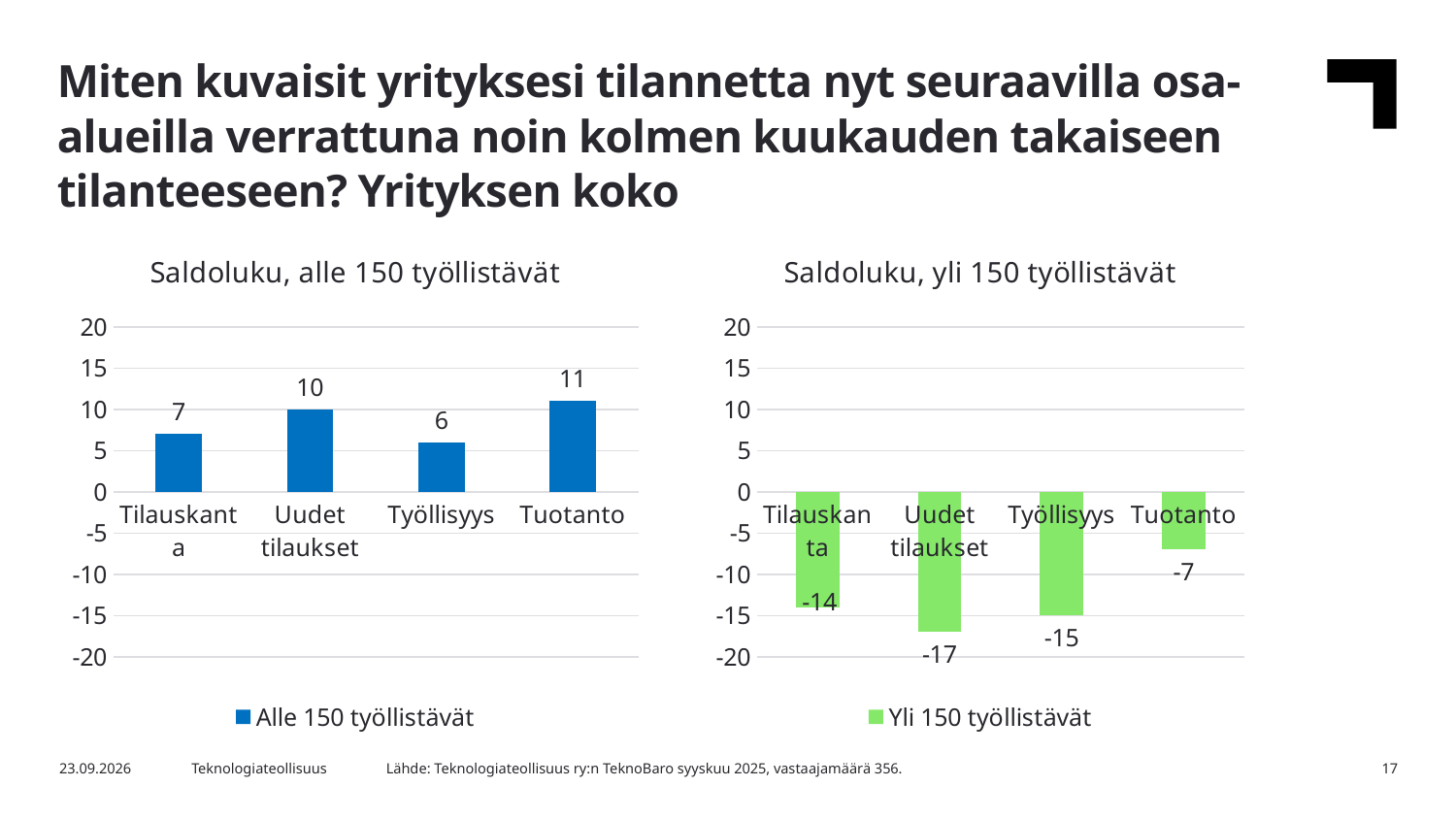
In the chart 'Saldoluku, alle 150 työllistävät', which category has the lowest value? Työllisyys In the chart 'Saldoluku, alle 150 työllistävät', what is the value for Uudet tilaukset? 10 What kind of chart is 'Saldoluku, alle 150 työllistävät'? Bar chart In the chart 'Saldoluku, alle 150 työllistävät', which category has the highest value? Tuotanto In the chart 'Saldoluku, yli 150 työllistävät', which is larger, the value for Tilauskanta or the value for Työllisyys? Tilauskanta In the chart 'Saldoluku, alle 150 työllistävät', what is the difference between the values for Tuotanto and Työllisyys? 5 In the chart 'Saldoluku, yli 150 työllistävät', which category has the lowest value? Uudet tilaukset In the chart 'Saldoluku, yli 150 työllistävät', what is the difference between the values for Tilauskanta and Uudet tilaukset? 3 In the chart 'Saldoluku, alle 150 työllistävät', is the value for Tuotanto greater or less than 10? greater What legend entry is shown under the chart 'Saldoluku, yli 150 työllistävät'? Yli 150 työllistävät How many categories are shown in the chart 'Saldoluku, yli 150 työllistävät'? 4 In the chart 'Saldoluku, yli 150 työllistävät', what is the value for Tuotanto? -7